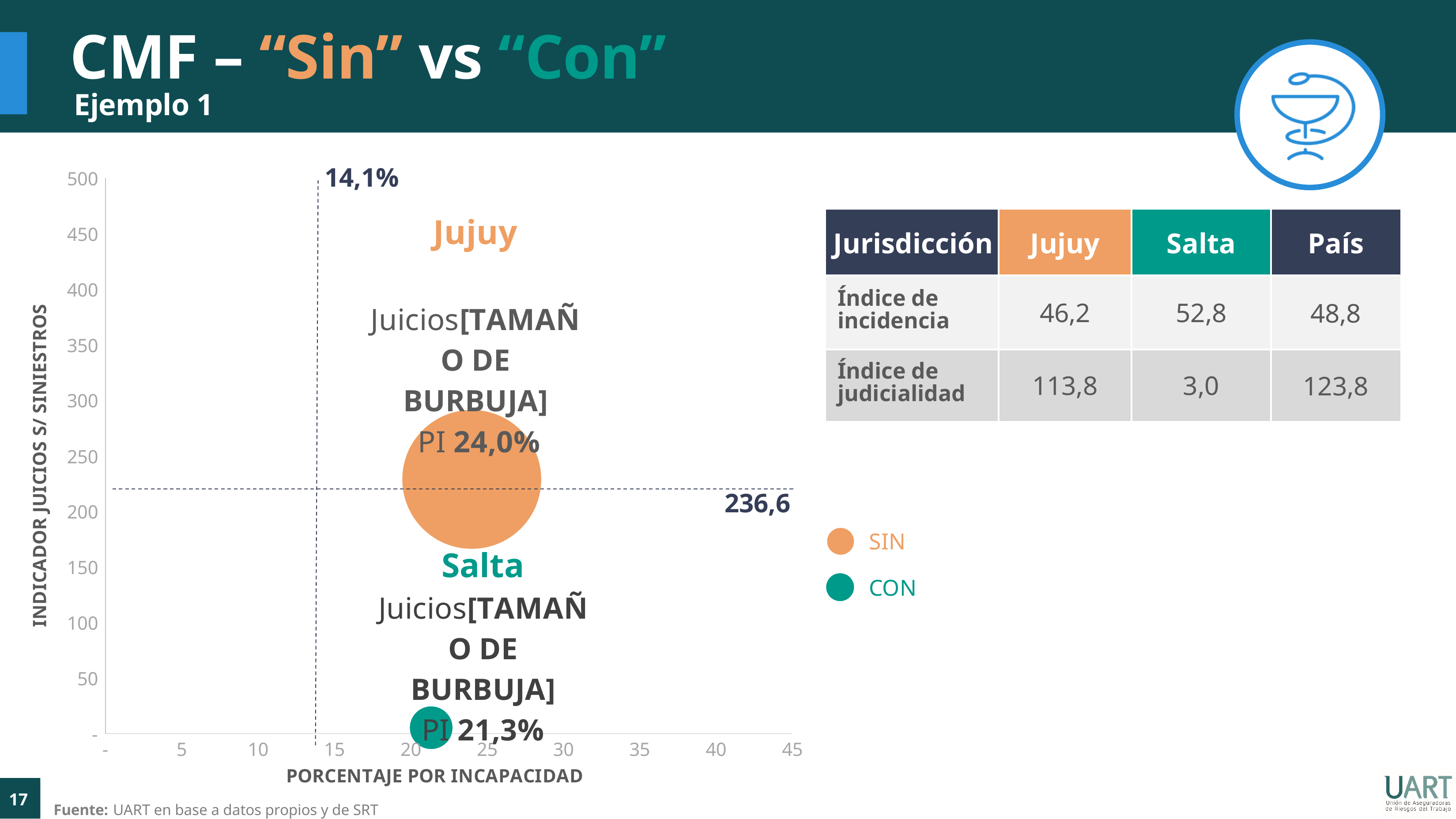
Which bubble sits higher on the y axis (Indicador juicios s/ siniestros), Jujuy or Salta? Jujuy Is the y-axis value of the Jujuy bubble greater or less than 100? greater How many series does the legend list? 2 How many bubbles are plotted on the chart? 2 What PI value is labelled on the Salta bubble? 21,3% What value is labelled on the horizontal dashed reference line? 236,6 What is the difference between the PI values of Jujuy and Salta? 2,7 percentage points What PI value is labelled on the Jujuy bubble? 24,0% What is the title of the x axis of the chart? PORCENTAJE POR INCAPACIDAD What value is labelled on the vertical dashed reference line? 14,1% Is the y-axis value of the Salta bubble greater or less than 50? less What kind of chart is shown on the slide? bubble chart